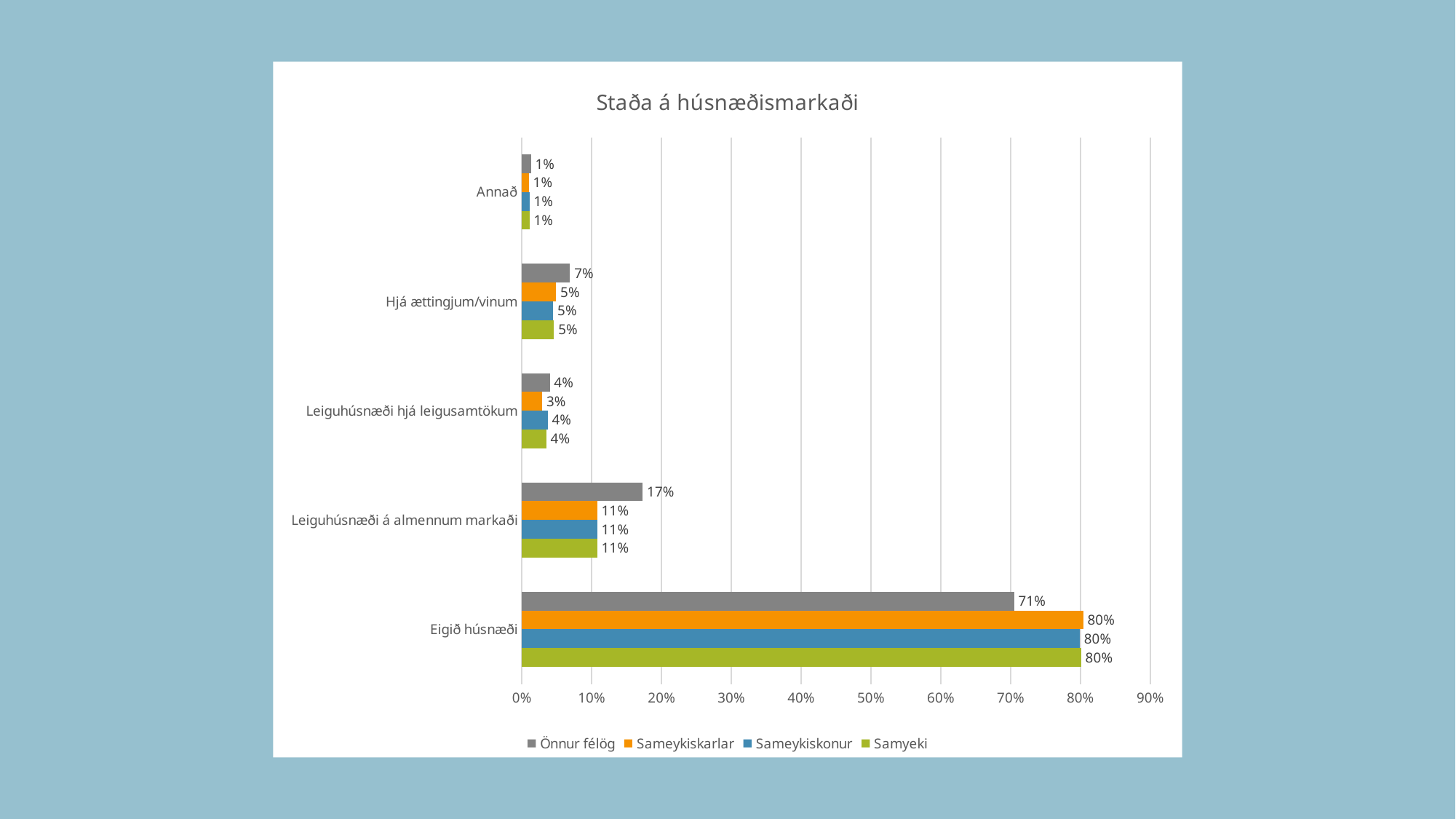
Which category has the highest value for Sameykiskonur? Eigið húsnæði What is the value for Samyeki in the Leiguhúsnæði á almennum markaði category? 11% What is the value for Önnur félög in the Hjá ættingjum/vinum category? 7% Which category has the lowest value for Önnur félög? Annað How many categories are shown on the chart? 5 What kind of chart is shown on the slide? bar chart What is the difference between Sameykiskarlar and Önnur félög in the Eigið húsnæði category? 9% How many series does the legend list? 4 What is the value for Önnur félög in the Eigið húsnæði category? 71% Is the value for Önnur félög in the Eigið húsnæði category greater or less than 80%? less Which is larger in the Leiguhúsnæði á almennum markaði category: Önnur félög or Sameykiskonur? Önnur félög What is the value for Sameykiskarlar in the Leiguhúsnæði hjá leigusamtökum category? 3%